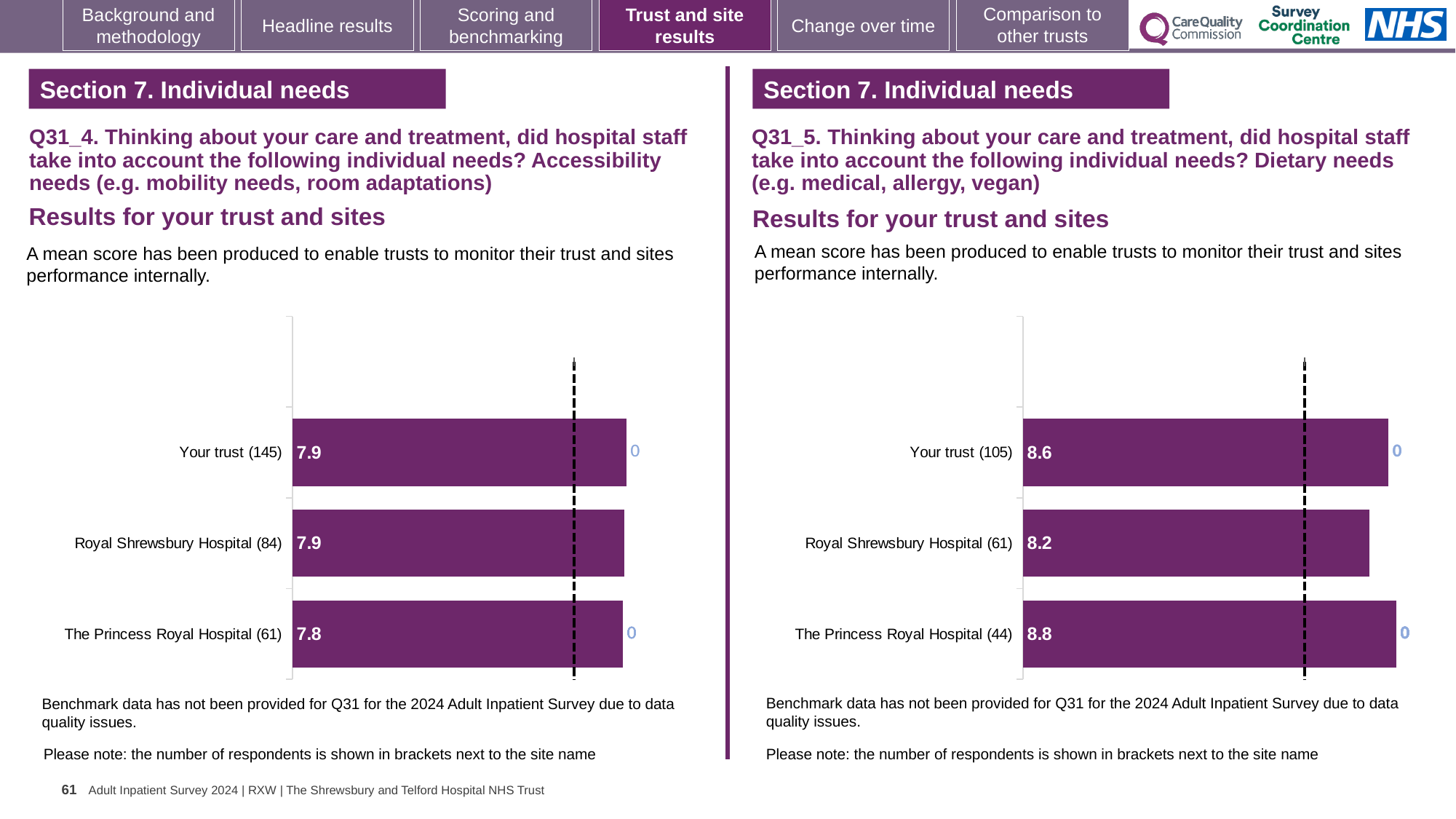
In the Q31_5 chart on the right, which has the larger mean score: Your trust (105) or Royal Shrewsbury Hospital (61)? Your trust (105) In the Q31_4 chart on the left, what is the mean score for The Princess Royal Hospital (61)? 7.8 How many respondents are shown in brackets for Your trust in the Q31_5 chart on the right? 105 What type of chart is used on the left for Q31_4? Bar chart In the Q31_5 chart on the right, which site has the lowest mean score? Royal Shrewsbury Hospital (61) In the Q31_5 chart on the right, what is the mean score for Royal Shrewsbury Hospital (61)? 8.2 In the Q31_4 chart on the left, which site has the lowest mean score? The Princess Royal Hospital (61) In the Q31_4 chart on the left, how many bars are plotted? 3 In the Q31_5 chart (Dietary needs) on the right, what is the mean score for Your trust (105)? 8.6 In the Q31_4 chart (Accessibility needs) on the left, what is the mean score for Your trust (145)? 7.9 In the Q31_5 chart on the right, what is the difference between the mean scores of The Princess Royal Hospital (44) and Royal Shrewsbury Hospital (61)? 0.6 In the Q31_5 chart on the right, which site has the highest mean score? The Princess Royal Hospital (44)